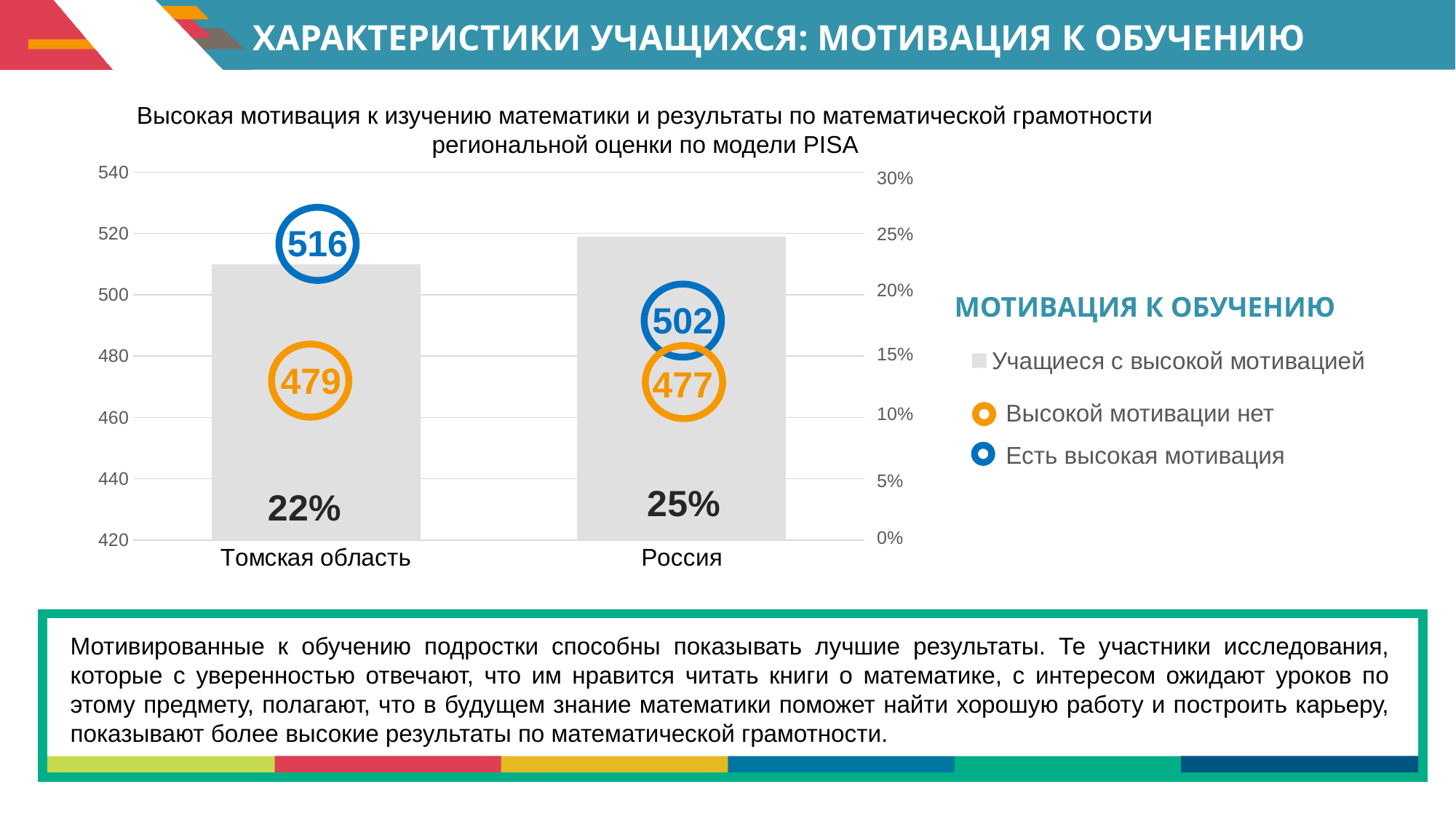
Which category has the higher score for students with high motivation (Есть высокая мотивация)? Томская область What is the score for students without high motivation (Высокой мотивации нет) in Россия? 477 How many series does the legend list? 3 Which series is shown with orange circle markers? Высокой мотивации нет How many categories are shown on the x axis? 2 What is the score for students with high motivation (Есть высокая мотивация) in Томская область? 516 What share of students in Россия have high motivation (Учащиеся с высокой мотивацией)? 25% Which is larger: the share of highly motivated students in Томская область or in Россия? Россия What share of students in Томская область have high motivation (Учащиеся с высокой мотивацией)? 22% What is the difference between the scores of motivated and unmotivated students in Россия? 25 What is the difference between the scores of motivated and unmotivated students in Томская область? 37 Is the score for students without high motivation in Томская область greater or less than 480? less